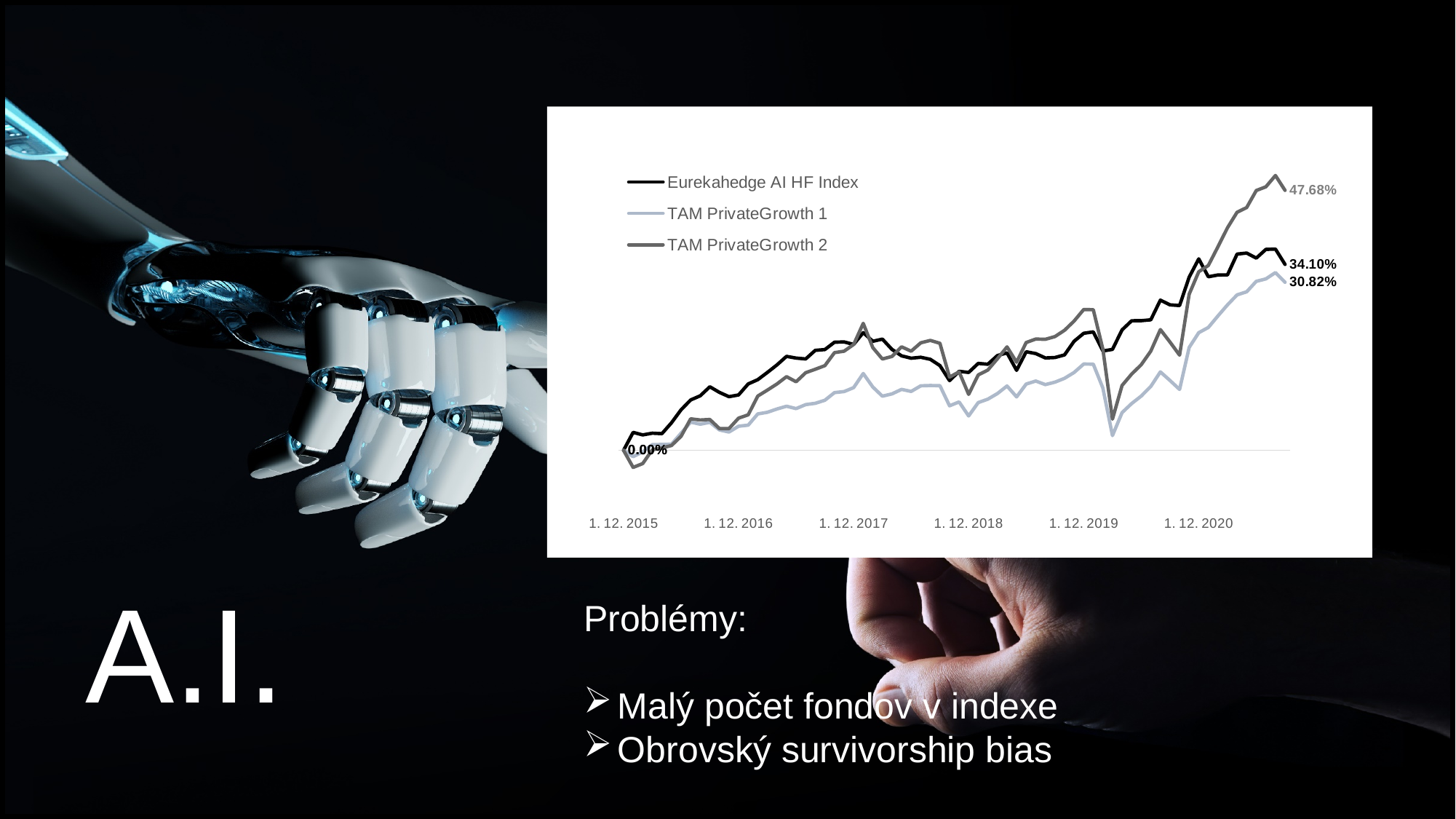
What is the final labelled value of the Eurekahedge AI HF Index series? 34.10% What is the difference between the final values of the Eurekahedge AI HF Index and TAM PrivateGrowth 1? 3.28% Which ends higher, the Eurekahedge AI HF Index or TAM PrivateGrowth 1? Eurekahedge AI HF Index Overall, do the series rise or fall from 1. 12. 2015 to the end of the chart? Rise What type of chart is shown on the slide? Line chart Which series ends at the highest value on the chart? TAM PrivateGrowth 2 What value is labelled at the start of the series on the chart? 0.00% What is the difference between the final values of TAM PrivateGrowth 2 and the Eurekahedge AI HF Index? 13.58% How many series does the chart legend list? 3 What is the final labelled value of the TAM PrivateGrowth 2 series? 47.68% What is the final labelled value of the TAM PrivateGrowth 1 series? 30.82% Which series ends at the lowest value on the chart? TAM PrivateGrowth 1